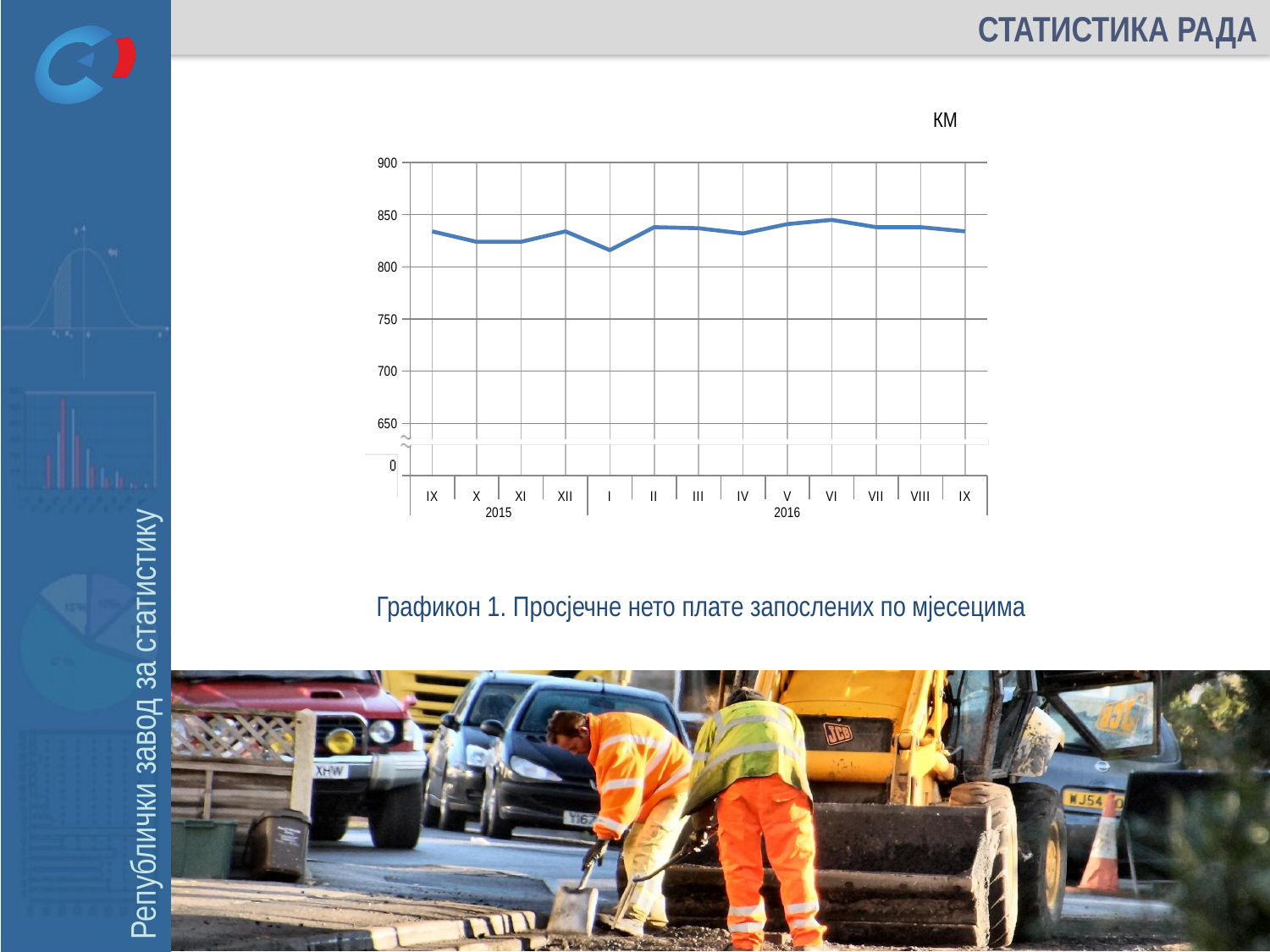
How many monthly data points are plotted on the chart? 13 Which month has the lowest average net wage on the chart? I 2016 Does the line rise or fall from XII 2015 to I 2016? fall What unit is indicated above the chart? KM Which is larger, the value for X 2015 or the value for II 2016? II 2016 What kind of chart is shown on the slide? line chart Is the value for X 2015 greater or less than 850? less Is the value for VI 2016 greater or less than 800? greater Is the value for I 2016 greater or less than 850? less Which is larger, the value for I 2016 or the value for VI 2016? VI 2016 What is the caption of the chart? Графикон 1. Просјечне нето плате запослених по мјесецима Which month has the highest average net wage on the chart? VI 2016